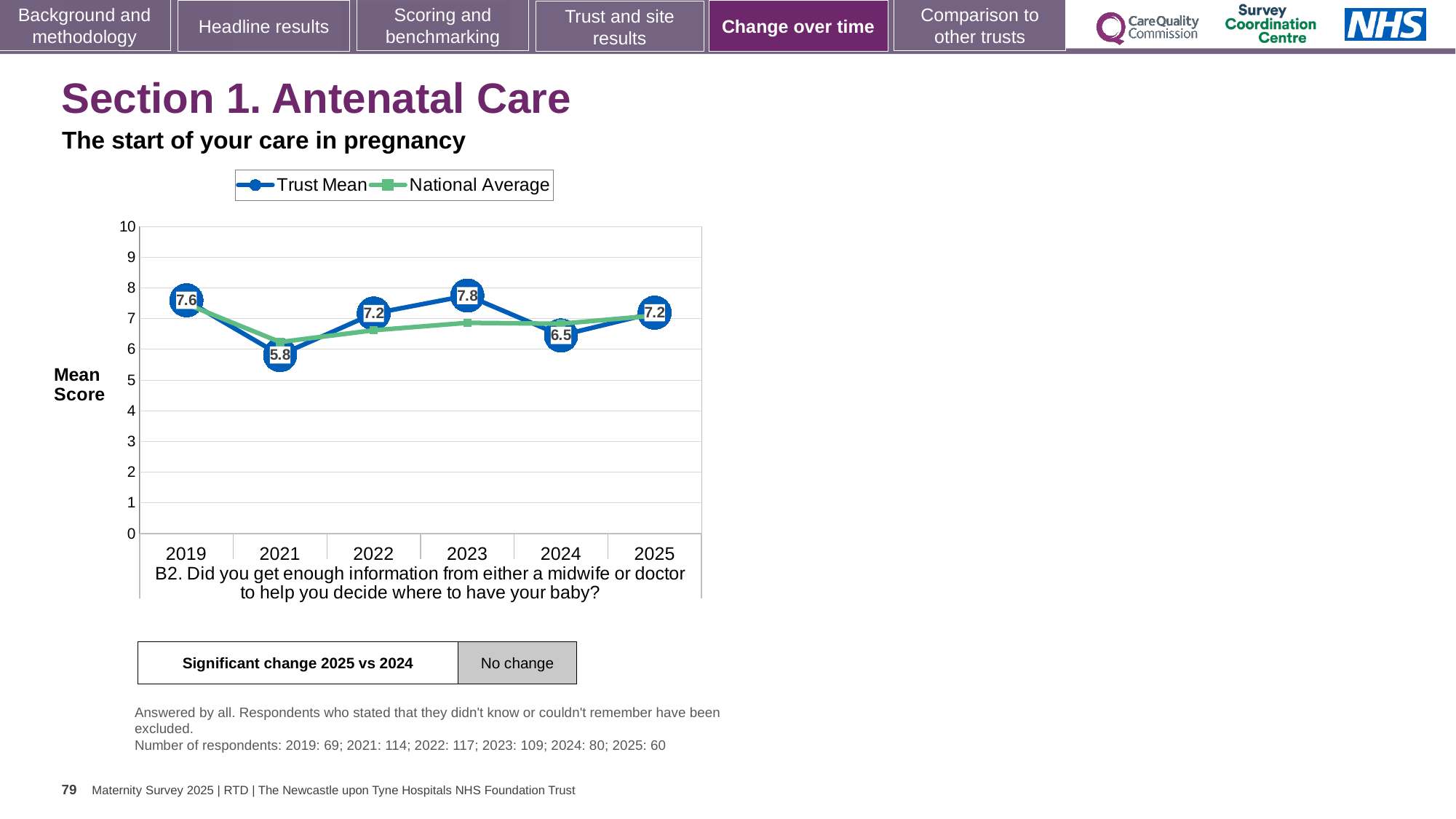
Which is larger, the Trust Mean in 2019 or in 2024? 2019 Is the National Average for 2021 greater or less than 7? less Does the Trust Mean rise or fall from 2023 to 2024? fall What is the Trust Mean score for 2019? 7.6 What kind of chart is shown? line chart What is the Trust Mean score for 2021? 5.8 In which year is the Trust Mean highest? 2023 In which year is the Trust Mean lowest? 2021 What is the difference between the Trust Mean in 2023 and in 2021? 2.0 How many series does the legend list? 2 How many years are shown on the x axis? 6 What is the Trust Mean score for 2024? 6.5